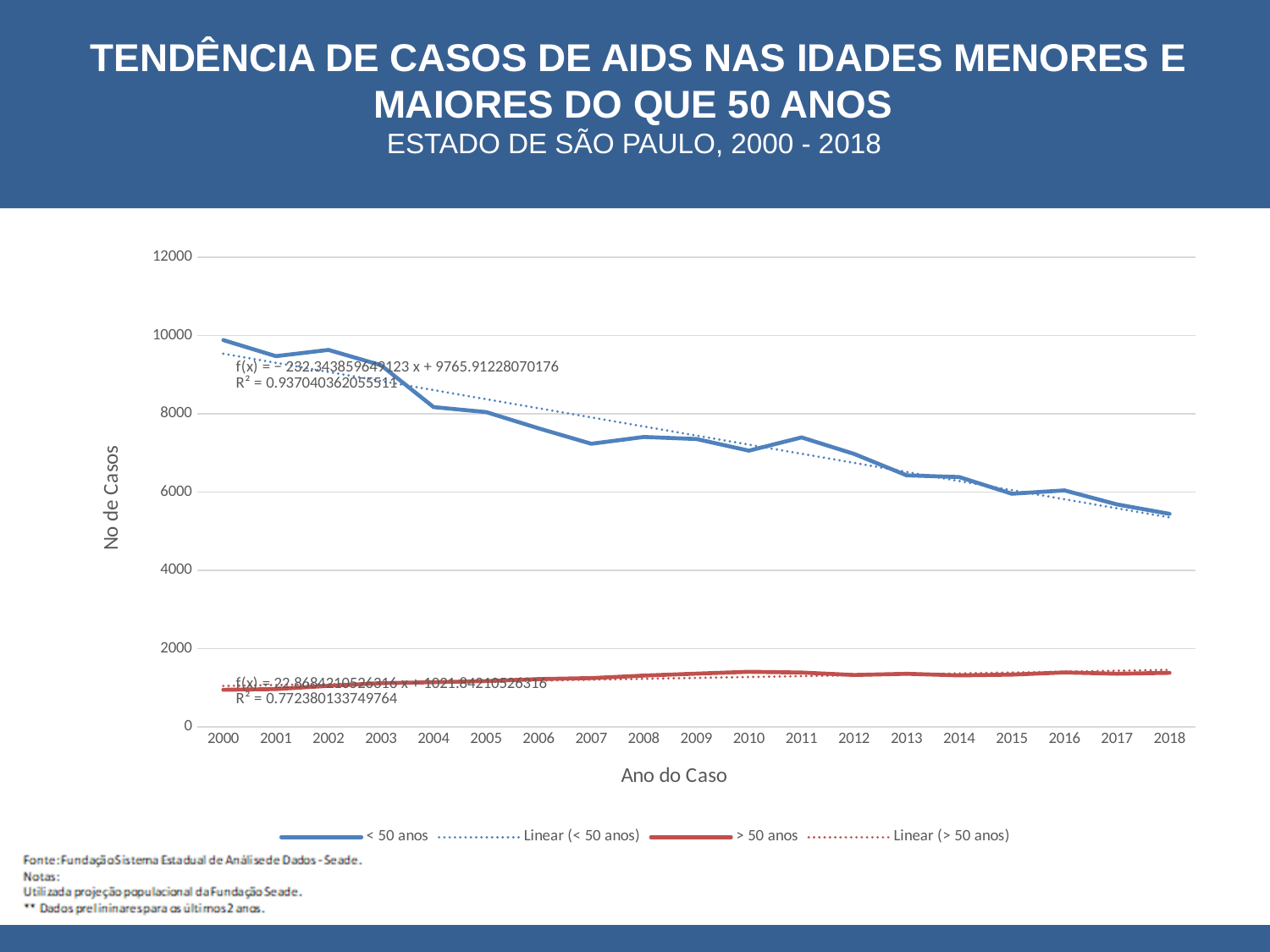
What is the title of the y axis? No de Casos What is the title of the x axis? Ano do Caso Is the value for '< 50 anos' in 2018 greater or less than 6000? less In which year is the '< 50 anos' series at its highest? 2000 What kind of chart is shown on the slide? line chart How many entries does the chart legend list? 4 In 2010, which series has the larger value, '< 50 anos' or '> 50 anos'? < 50 anos Is the value for '< 50 anos' in 2000 greater or less than 8000? greater Is the value for '< 50 anos' in 2007 greater or less than 8000? less How many years are plotted along the x axis? 19 Does the '< 50 anos' line rise or fall from 2000 to 2018? fall